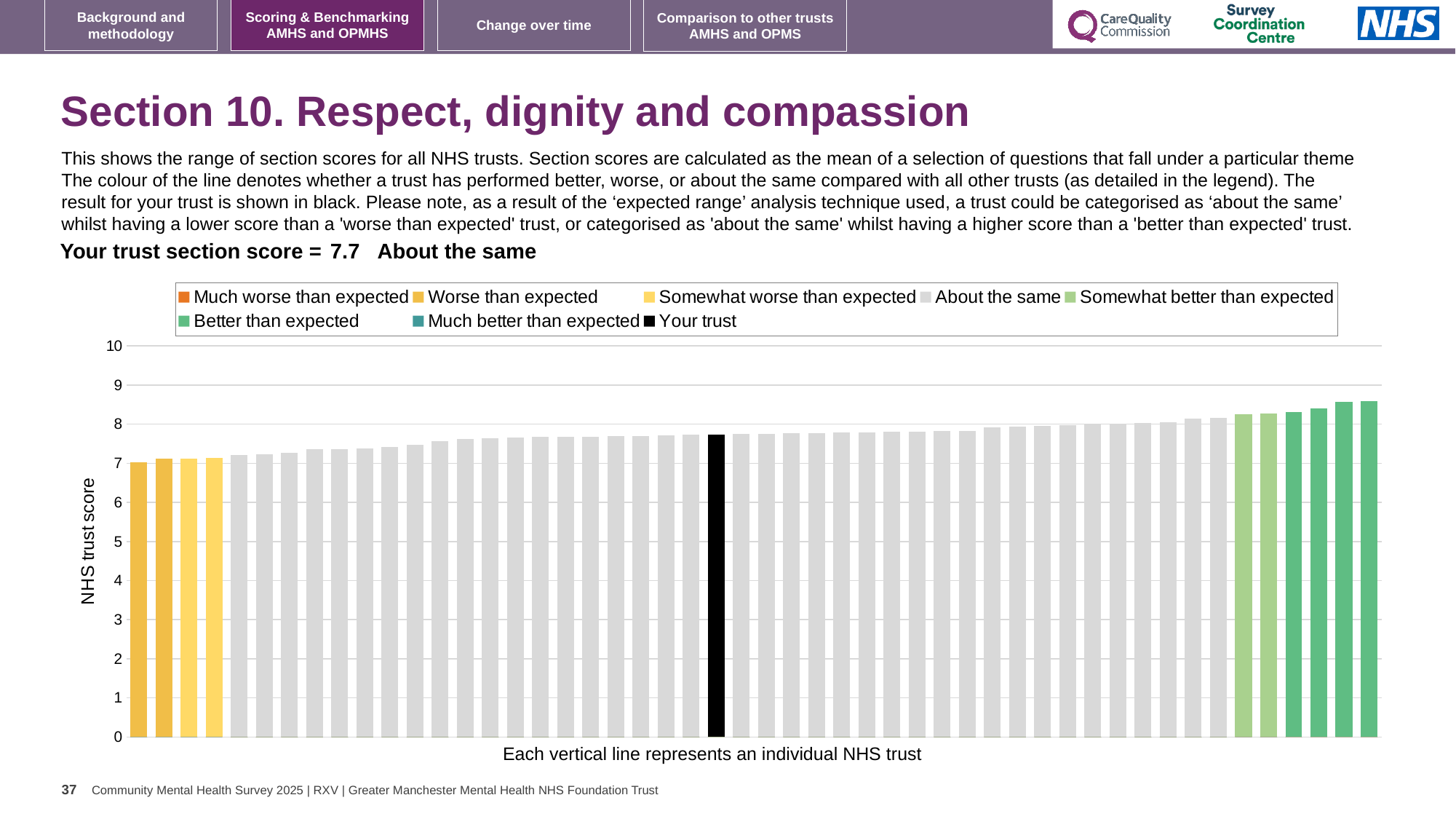
Is the value for your trust greater or less than 8? less Is the highest trust score on the chart greater or less than 8? greater Is the lowest trust score on the chart greater or less than 8? less Do the bar values rise or fall from left to right along the x axis? rise What is the title of the vertical axis? NHS trust score How many entries does the chart legend list? 8 What kind of chart is shown on the slide? bar chart What is the section score for your trust? 7.7 What colour is the bar representing your trust? black Which category is your trust placed in compared with other trusts? About the same